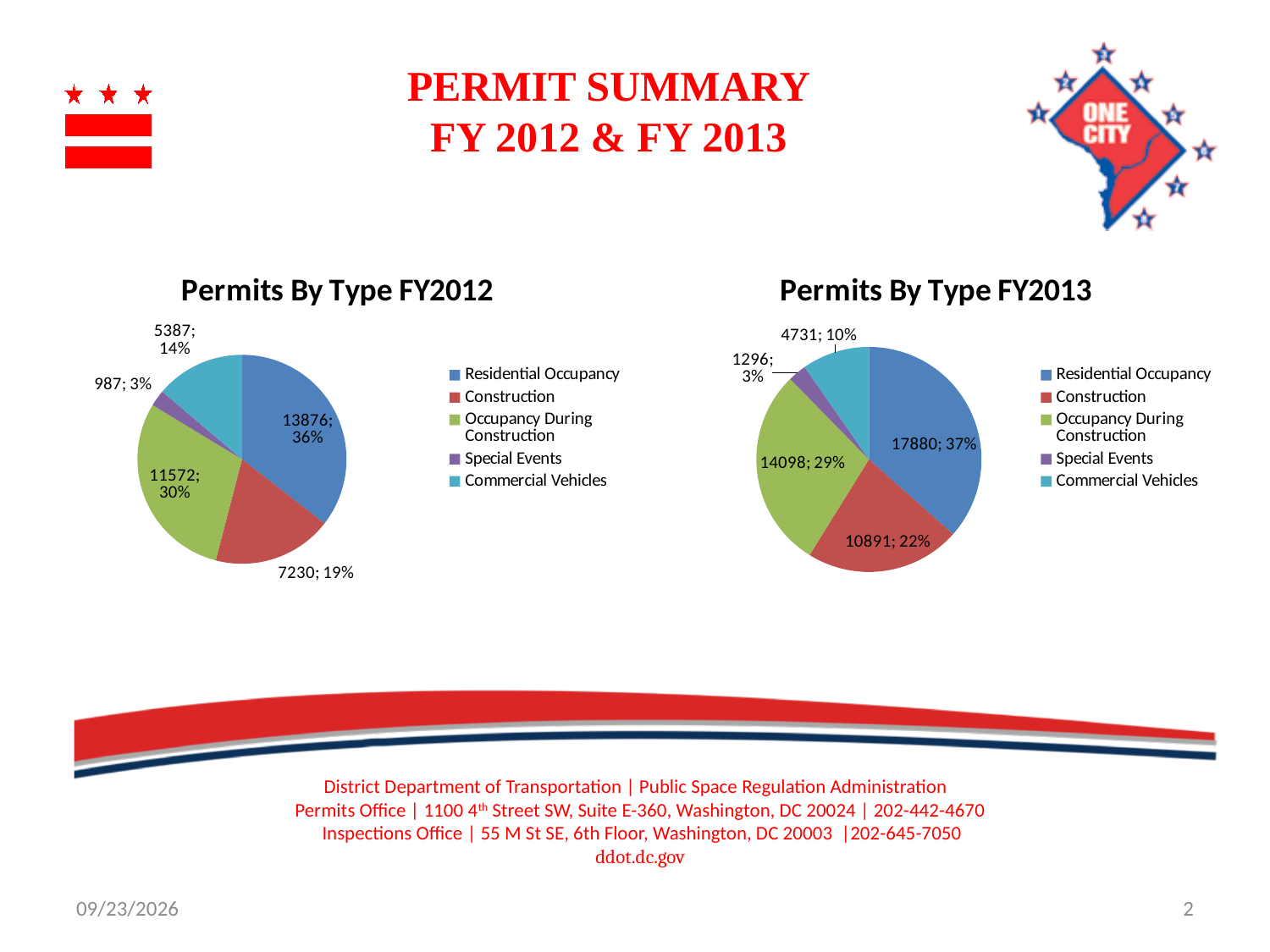
In the Permits By Type FY2013 chart, what value is shown for Construction? 10891; 22% Which is larger: Special Events in the FY2012 chart or Special Events in the FY2013 chart? FY2013 How many permit types are shown in the Permits By Type FY2013 chart? 5 In the Permits By Type FY2013 chart, what is the difference between the Residential Occupancy count and the Occupancy During Construction count? 3782 In the Permits By Type FY2012 chart, what value is shown for Residential Occupancy? 13876; 36% In the Permits By Type FY2013 chart, what share of the pie is Commercial Vehicles? 10% In the Permits By Type FY2012 chart, what is the difference between the Construction count and the Commercial Vehicles count? 1843 What kind of chart is Permits By Type FY2012? Pie chart In the Permits By Type FY2012 chart, which permit type has the largest slice? Residential Occupancy In the Permits By Type FY2013 chart, which permit type has the smallest slice? Special Events In the Permits By Type FY2013 chart, which permit type is shown in green? Occupancy During Construction In the Permits By Type FY2012 chart, what share of the pie is Occupancy During Construction? 30%